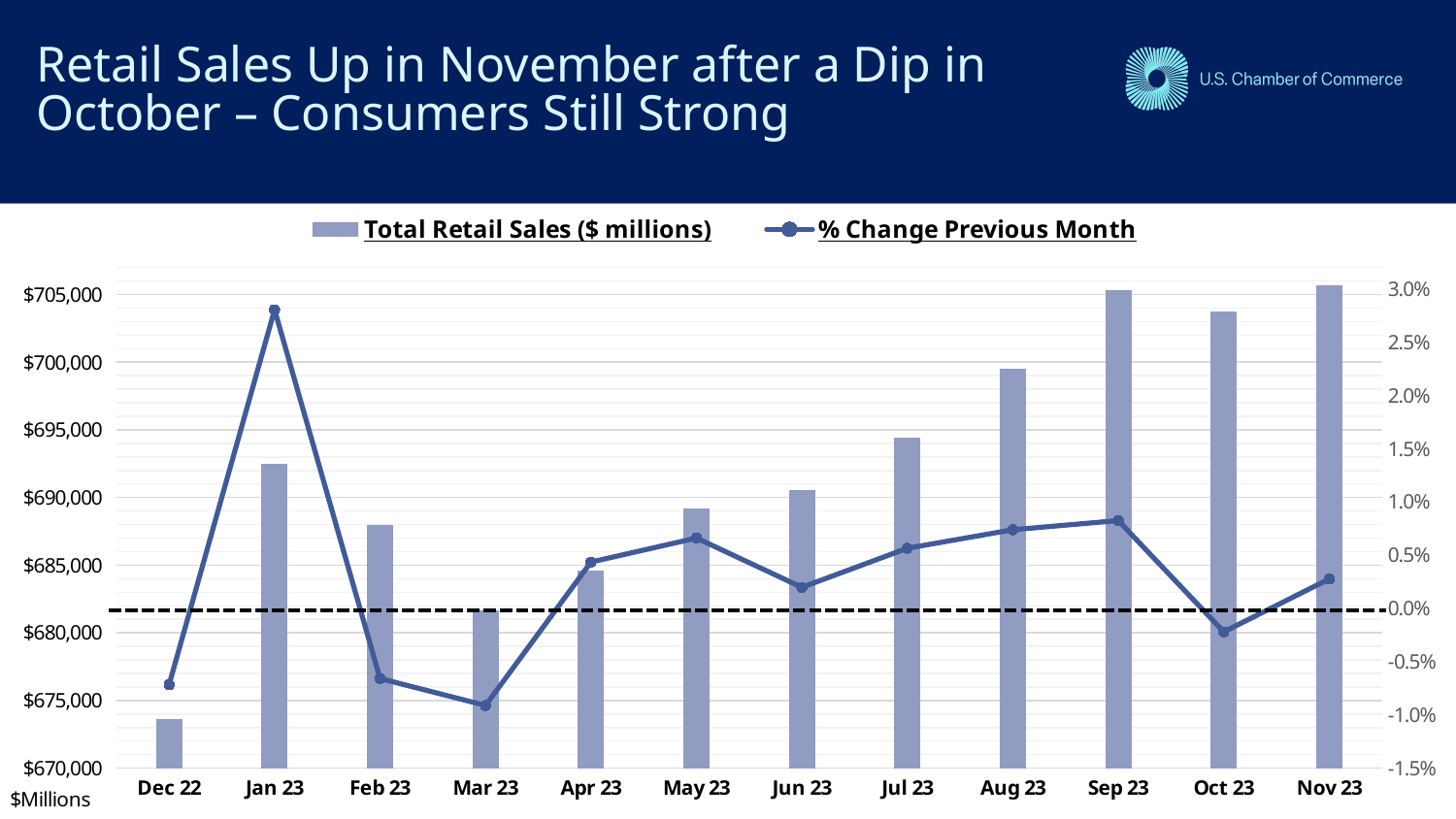
Which has the larger Total Retail Sales bar, Jan 23 or Feb 23? Jan 23 Is the % Change Previous Month value for Jan 23 greater or less than 2.5%? greater Which month has the lowest Total Retail Sales bar? Dec 22 Do the Total Retail Sales bars rise or fall from Apr 23 to Sep 23? rise Is the % Change Previous Month value for Oct 23 greater or less than 0.0%? less How many series does the legend list? 2 What kind of chart is shown on the slide? A combined bar and line chart Is the Total Retail Sales value for Dec 22 greater or less than $675,000? less How many months are shown along the x axis? 12 Which month has the highest % Change Previous Month value? Jan 23 Which month has the lowest % Change Previous Month value? Mar 23